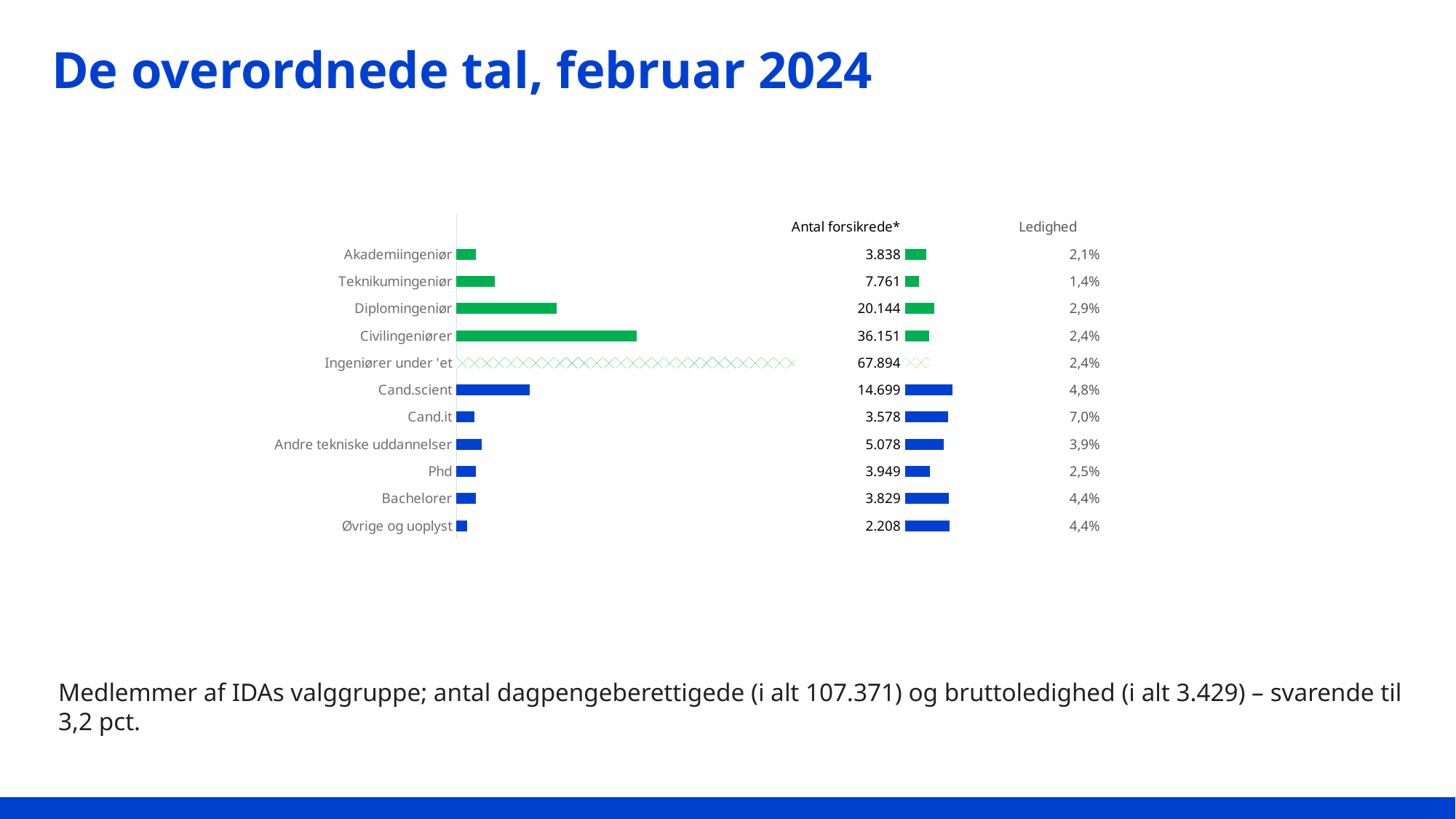
What is the difference in Ledighed between Cand.it and Cand.scient? 2,2 percentage points What is the difference in Antal forsikrede* between Civilingeniører and Diplomingeniør? 16.007 Which category has the lowest Antal forsikrede*? Øvrige og uoplyst Which category has the lowest Ledighed? Teknikumingeniør What is the Ledighed value for Cand.it? 7,0% What is the Antal forsikrede* value for Ingeniører under 'et? 67.894 Which has a larger Antal forsikrede*, Cand.scient or Diplomingeniør? Diplomingeniør How many categories are shown in the chart? 11 What colour is the bar for Cand.scient? Blue Which category has the highest Ledighed? Cand.it What is the value of Antal forsikrede* for Civilingeniører? 36.151 What kind of chart is shown on the slide? Bar chart